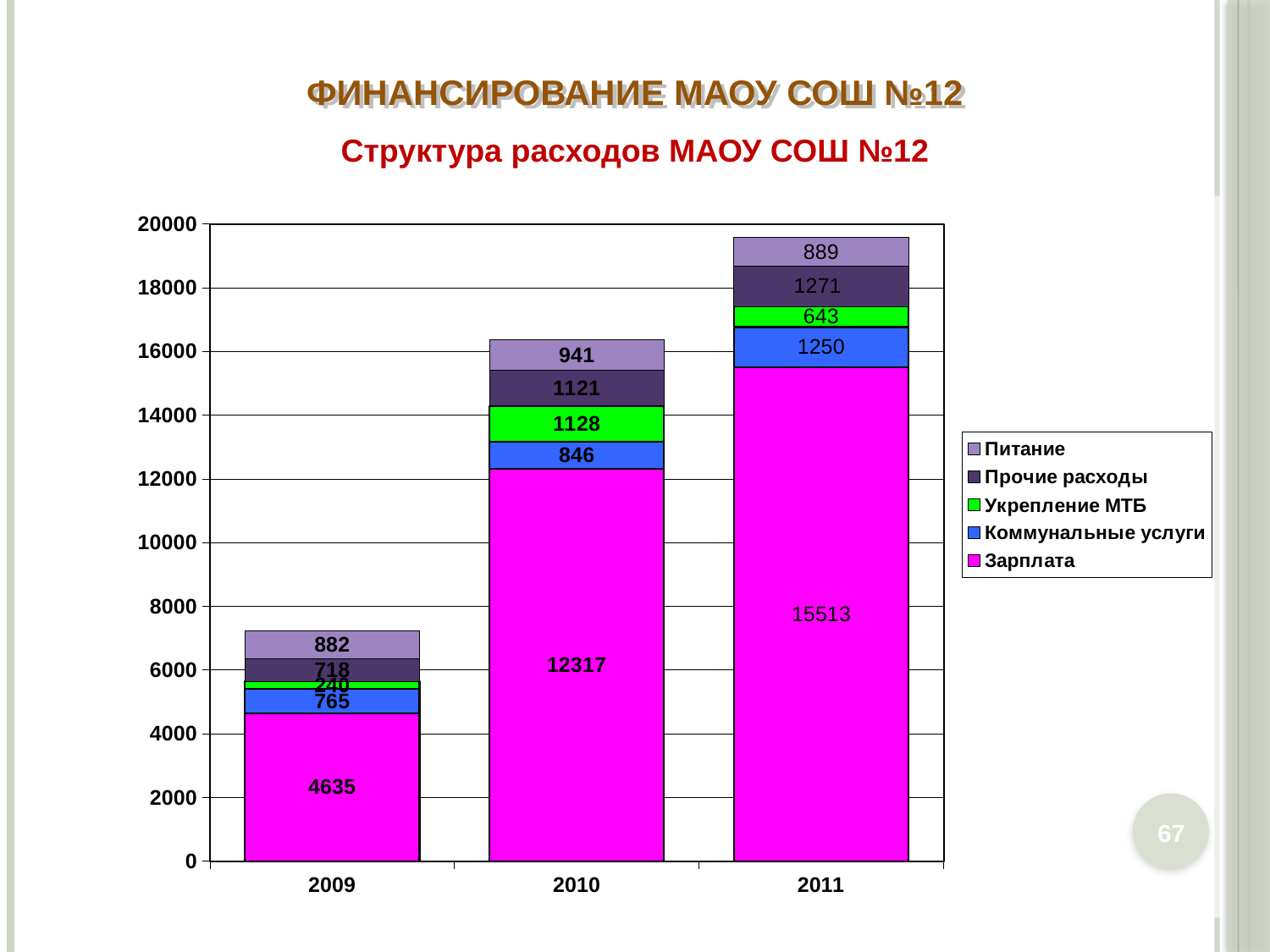
How many series does the legend list? 5 In which year is Укрепление МТБ the lowest? 2009 What is the total of the stacked bar for 2009? 7240 What is the value of Коммунальные услуги in 2009? 765 What type of chart is shown on the slide? Stacked bar chart Which is larger: Прочие расходы in 2011 or Питание in 2011? Прочие расходы How many years are shown on the x axis? 3 Does the total for Зарплата rise or fall from 2009 to 2011? Rise What is the value of Зарплата in 2011? 15513 What is the value of Укрепление МТБ in 2010? 1128 In which year is Зарплата the highest? 2011 What is the difference between Зарплата in 2010 and in 2009? 7682